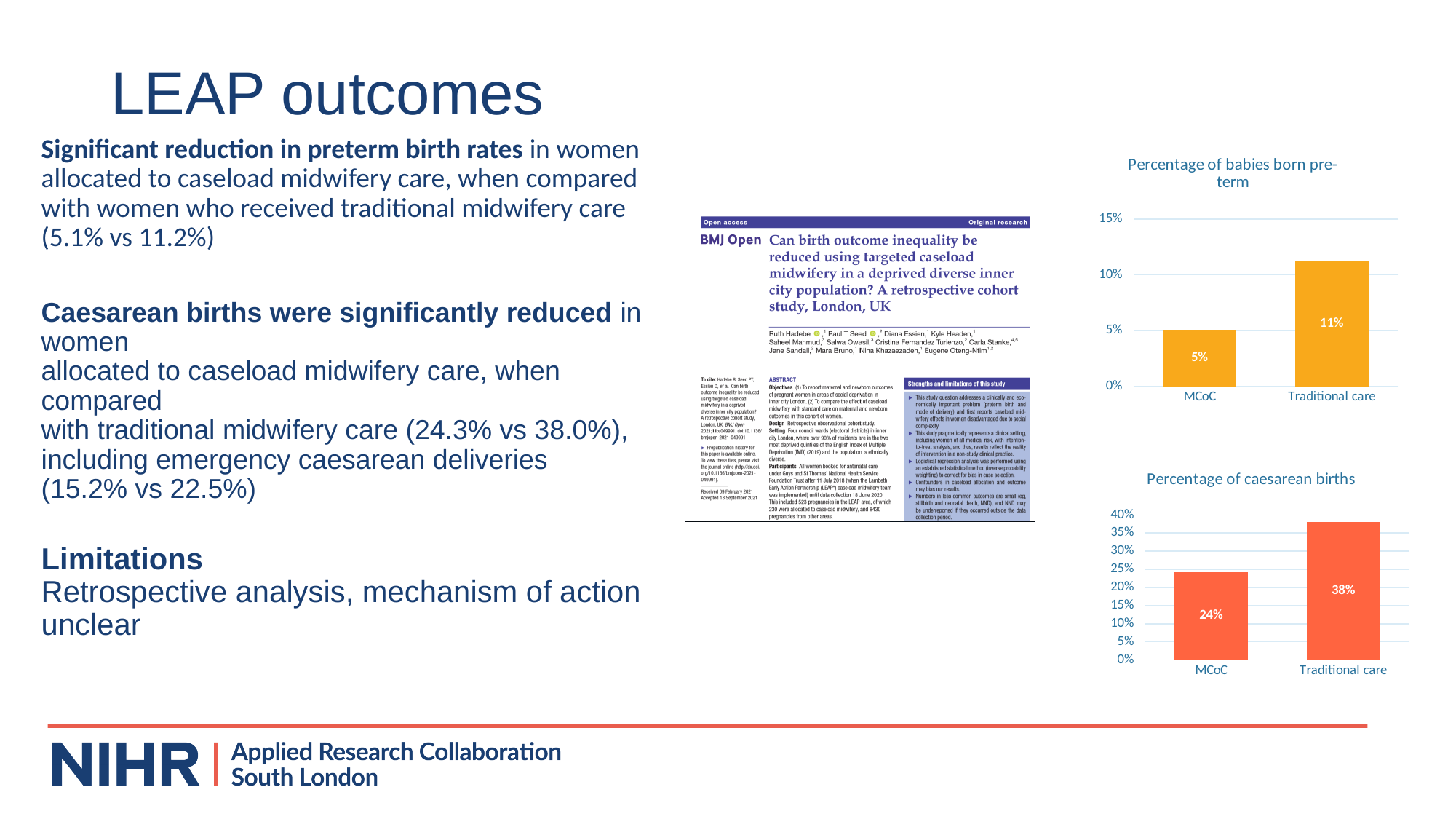
In the 'Percentage of babies born pre-term' chart, which category has the highest value? Traditional care In the 'Percentage of babies born pre-term' chart, what is the value for MCoC? 5% In the 'Percentage of caesarean births' chart, is the value for Traditional care greater or less than 30%? greater In the 'Percentage of babies born pre-term' chart, what is the difference between the Traditional care and MCoC values? 6% What colour are the bars in the 'Percentage of caesarean births' chart? Orange-red In the 'Percentage of caesarean births' chart, what is the value for Traditional care? 38% How many categories are shown in the 'Percentage of caesarean births' chart? 2 What type of chart is the 'Percentage of babies born pre-term' chart? Bar chart In the 'Percentage of caesarean births' chart, which category has the lowest value? MCoC In the 'Percentage of babies born pre-term' chart, what is the value for Traditional care? 11% In the 'Percentage of caesarean births' chart, what is the value for MCoC? 24% In the 'Percentage of caesarean births' chart, what is the difference between the Traditional care and MCoC values? 14%